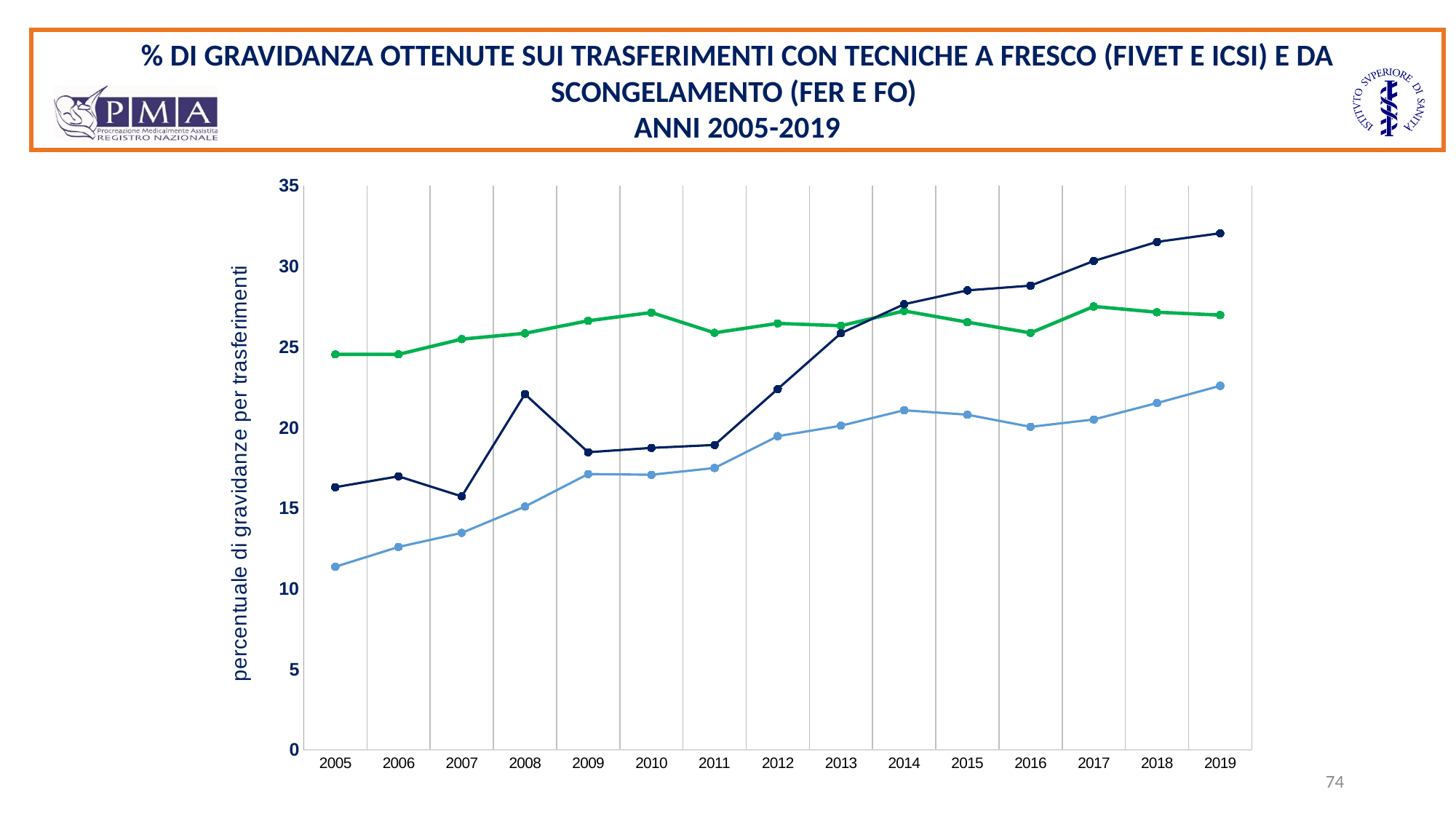
In 2019, which line has the higher value, the dark navy line or the green line? the dark navy line How many years are shown on the x axis of the chart? 15 Is the value of the dark navy line in 2019 greater or less than 30? greater What kind of chart is shown on the slide? line chart What is the label of the y axis of the chart? percentuale di gravidanze per trasferimenti How many lines are plotted on the chart? 3 Is the value of the green line in 2005 greater or less than 20? greater Is the value of the dark navy line in 2008 greater or less than 20? greater Does the light blue line generally rise or fall from 2005 to 2019? rise In which year does the light blue line reach its highest value? 2019 In 2005, which line has the higher value, the green line or the light blue line? the green line